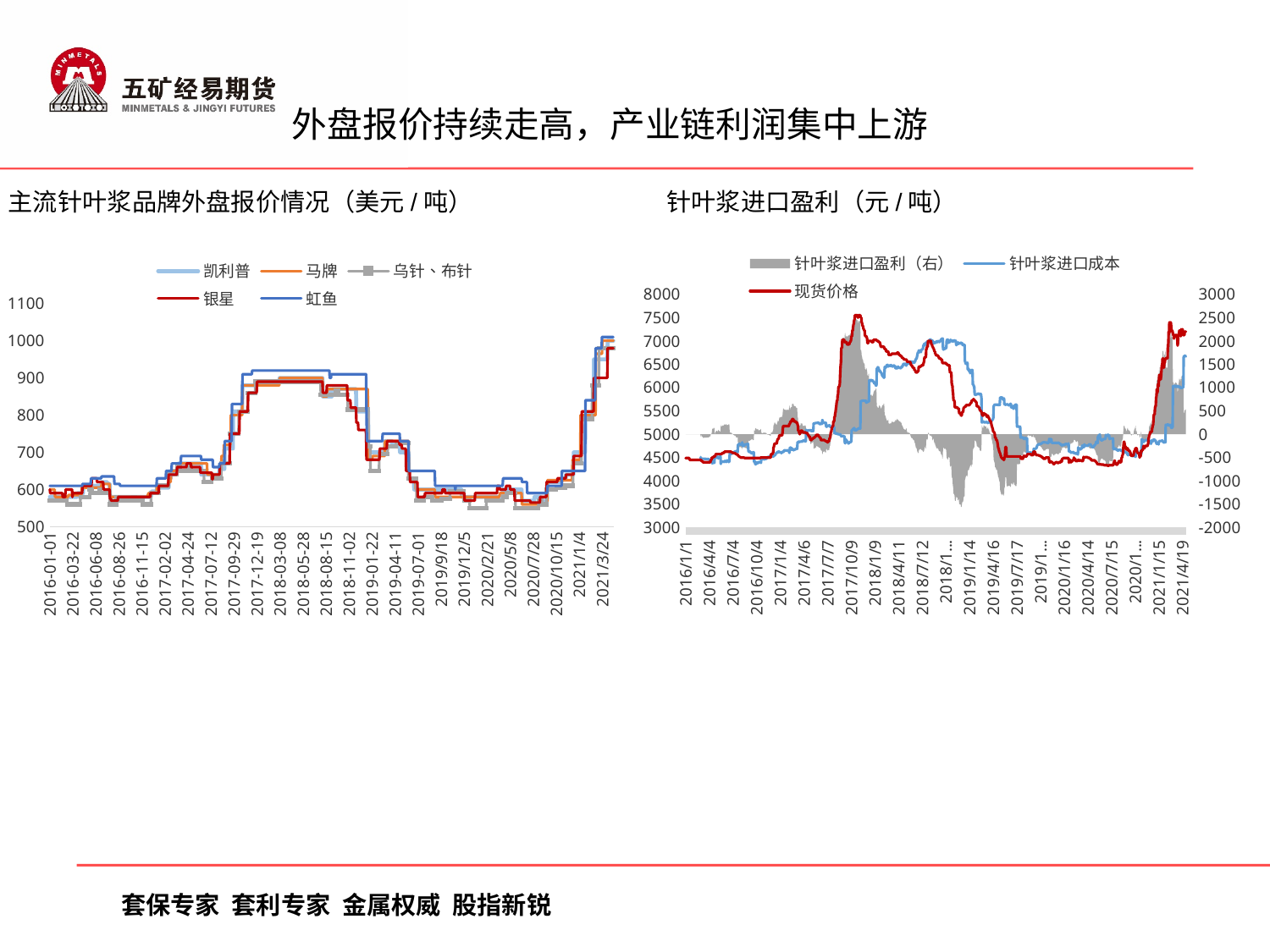
What type of chart is the left chart titled 主流针叶浆品牌外盘报价情况（美元/吨）? line chart How many series does the legend of the right chart (针叶浆进口盈利) list? 3 In the left chart (主流针叶浆品牌外盘报价情况), is the value for 虹鱼 at 2021/3/24 greater or less than 900? greater In the left chart (主流针叶浆品牌外盘报价情况), is the value for 银星 at 2016-01-01 greater or less than 700? less How many series does the legend of the left chart (主流针叶浆品牌外盘报价情况) list? 5 In the right chart (针叶浆进口盈利), is the value of 现货价格 at 2016/1/1 greater or less than 5000 on the left axis? less In the right chart (针叶浆进口盈利), which series is plotted on the right-hand axis according to the legend? 针叶浆进口盈利（右） In the left chart (主流针叶浆品牌外盘报价情况), do the quoted prices rise or fall between 2020/10/15 and 2021/3/24? rise In the right chart (针叶浆进口盈利), does 现货价格 rise or fall between 2018/7/12 and 2019/4/16? fall What unit is given in the title of the left chart (主流针叶浆品牌外盘报价情况)? 美元/吨